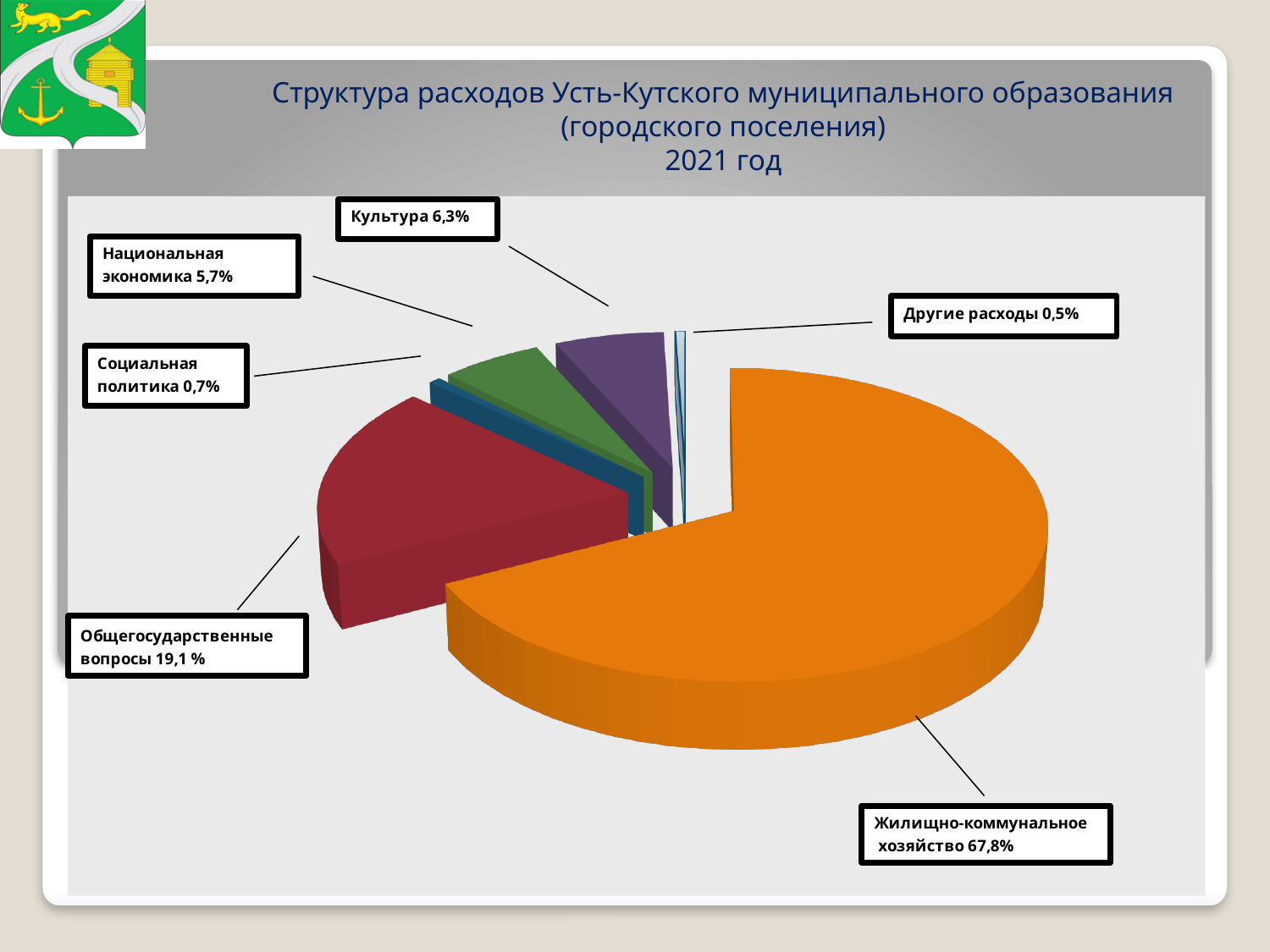
What share of expenditures goes to Жилищно-коммунальное хозяйство? 67,8% What share is shown for Социальная политика? 0,7% Which category has the smallest share of expenditures? Другие расходы What is the value shown for Общегосударственные вопросы? 19,1 % What is the value for Национальная экономика? 5,7% What kind of chart is shown on the slide? Pie chart What is the value for Другие расходы? 0,5% What is the difference between the shares of Жилищно-коммунальное хозяйство and Общегосударственные вопросы? 48,7 percentage points Which category has the largest share of expenditures? Жилищно-коммунальное хозяйство Which is larger, the share for Культура or for Национальная экономика? Культура How many categories are shown in the pie chart? 6 What percentage is labelled for Культура? 6,3%